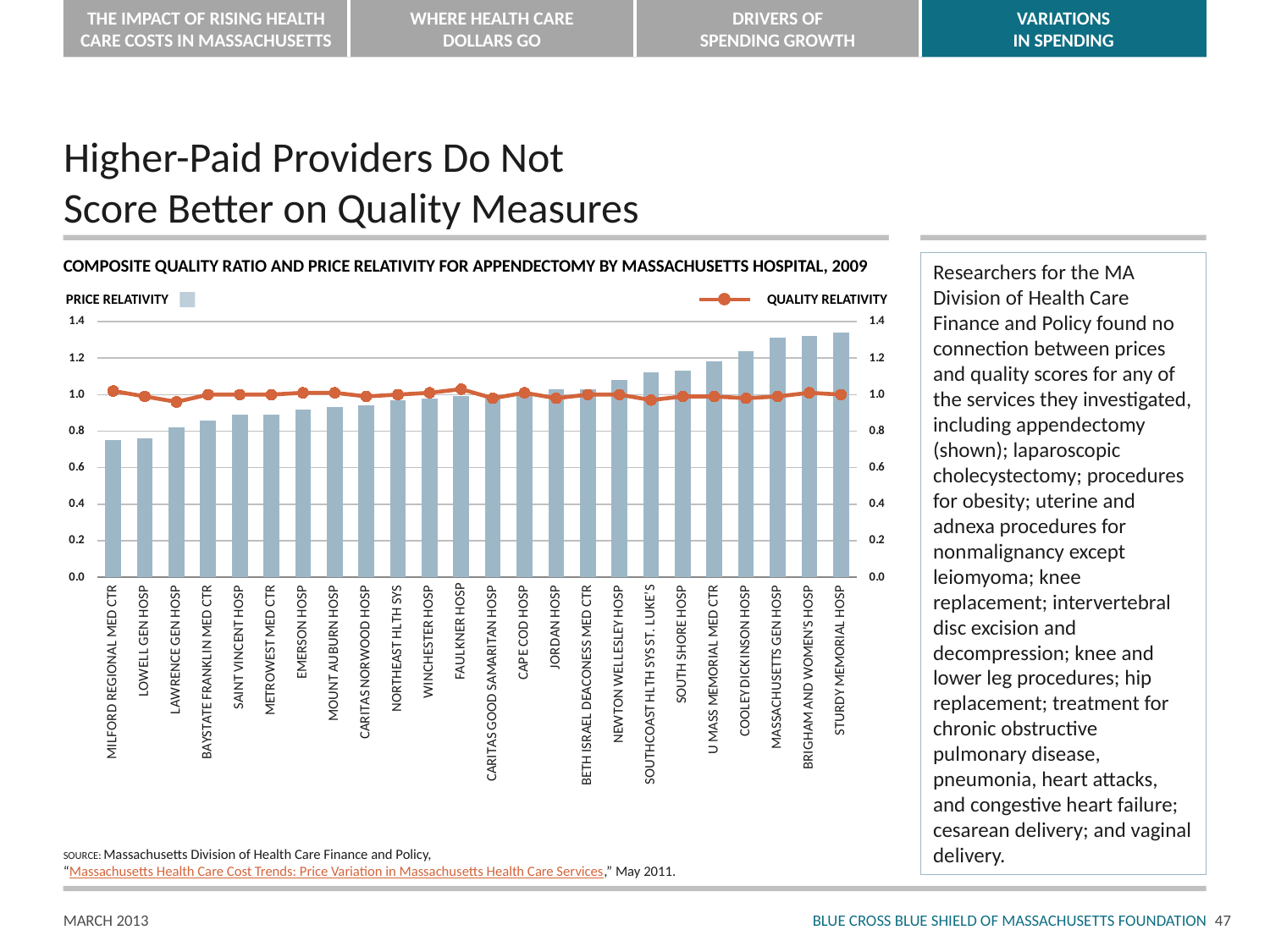
Do the price relativity bars rise or fall from left to right across the hospitals? Rise What is the title of the chart? Composite Quality Ratio and Price Relativity for Appendectomy by Massachusetts Hospital, 2009 Which has a higher price relativity, Massachusetts Gen Hosp or Lowell Gen Hosp? Massachusetts Gen Hosp Is the price relativity for Cooley Dickinson Hosp greater or less than 1.2? greater Which hospital has the highest price relativity? Sturdy Memorial Hosp Which series is shown as the orange line with markers? Quality Relativity How many hospitals are shown on the x axis? 24 Is the price relativity for Massachusetts Gen Hosp greater or less than 1.2? greater Is the price relativity for Milford Regional Med Ctr greater or less than 0.8? less What kind of chart is shown on the slide? A bar chart with a line overlay How many series does the legend list? 2